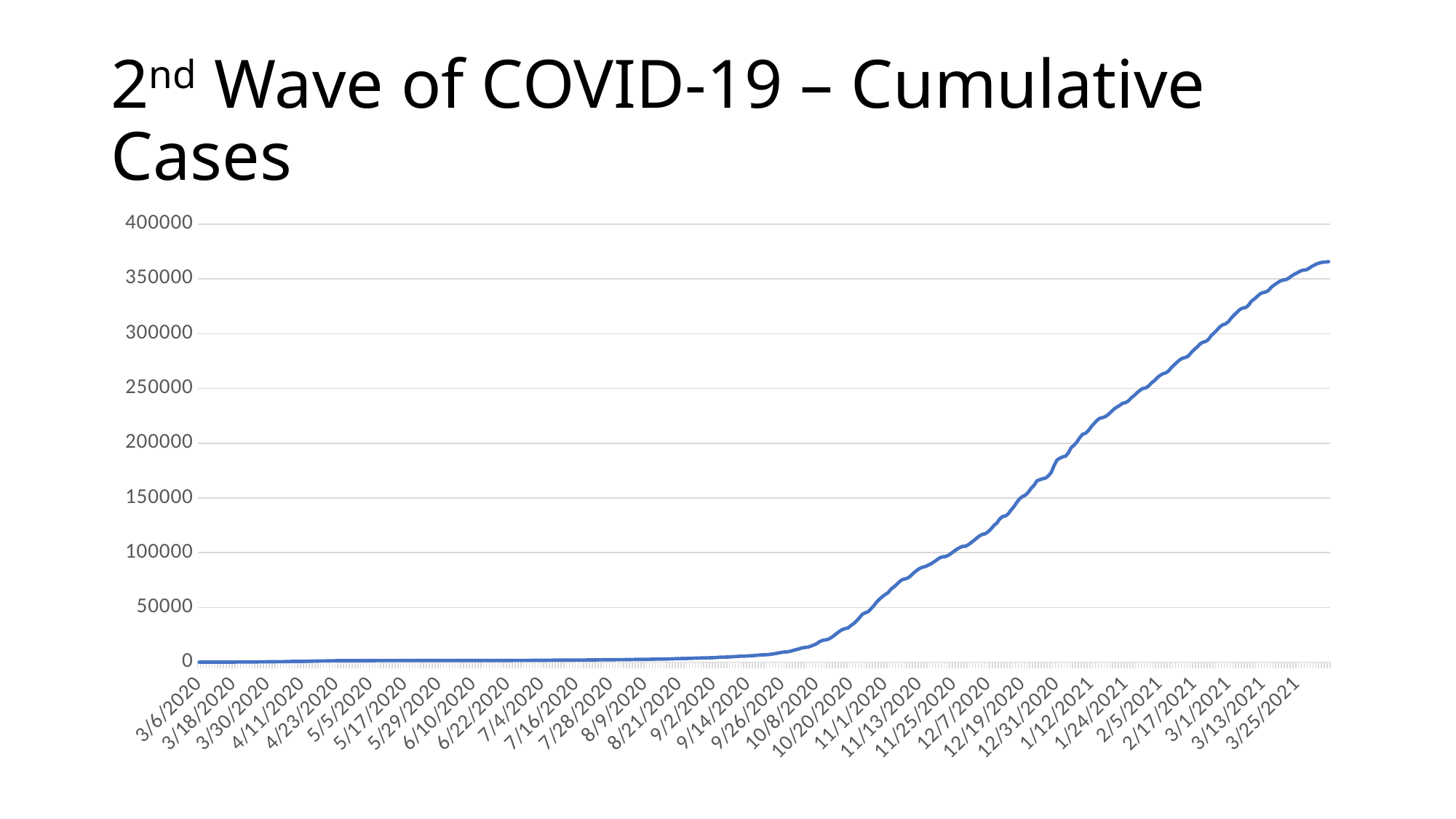
Is the value for 10/8/2020 greater or less than 50000? less Is the value for 9/14/2020 greater or less than 50000? less Is the value for 3/13/2021 greater or less than 300000? greater What is the highest value shown on the y axis of the chart? 400000 What is the title of the slide containing the chart? 2nd Wave of COVID-19 – Cumulative Cases What kind of chart is shown on the slide? line chart Do the cumulative case values rise or fall along the x axis from 3/6/2020 to 3/25/2021? rise